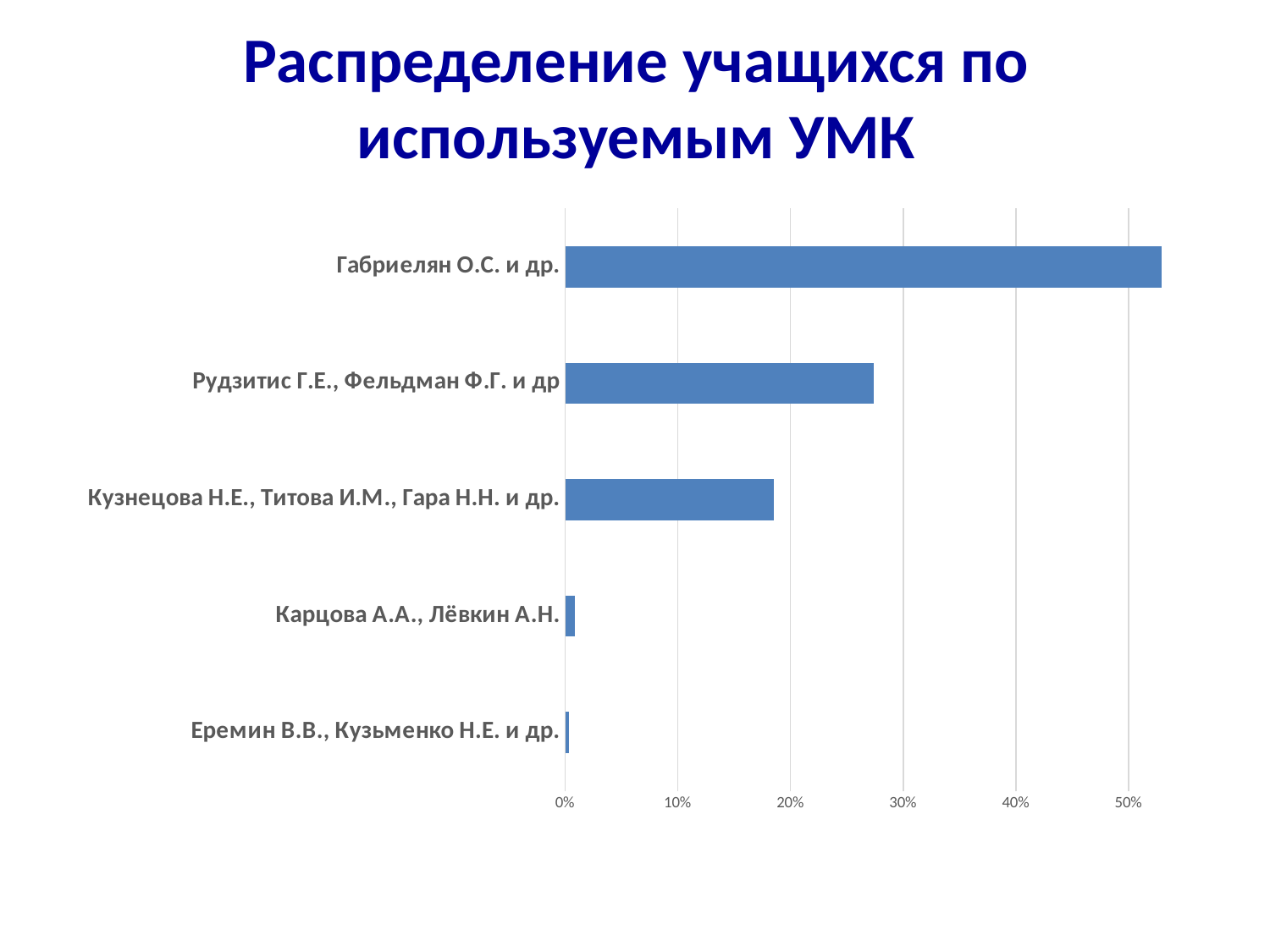
Is the value for Карцова А.А., Лёвкин А.Н. greater or less than 10%? less How many categories (УМК) are shown in the chart? 5 What is the title of the chart on the slide? Распределение учащихся по используемым УМК Which category has the lowest value? Еремин В.В., Кузьменко Н.Е. и др. Which is larger: the value for Рудзитис Г.Е., Фельдман Ф.Г. и др or the value for Кузнецова Н.Е., Титова И.М., Гара Н.Н. и др.? Рудзитис Г.Е., Фельдман Ф.Г. и др Is the value for Габриелян О.С. и др. greater or less than 50%? greater What kind of chart is shown on the slide? bar chart Is the value for Рудзитис Г.Е., Фельдман Ф.Г. и др greater or less than 30%? less Which is larger: the value for Карцова А.А., Лёвкин А.Н. or the value for Габриелян О.С. и др.? Габриелян О.С. и др. Which category has the highest value? Габриелян О.С. и др.